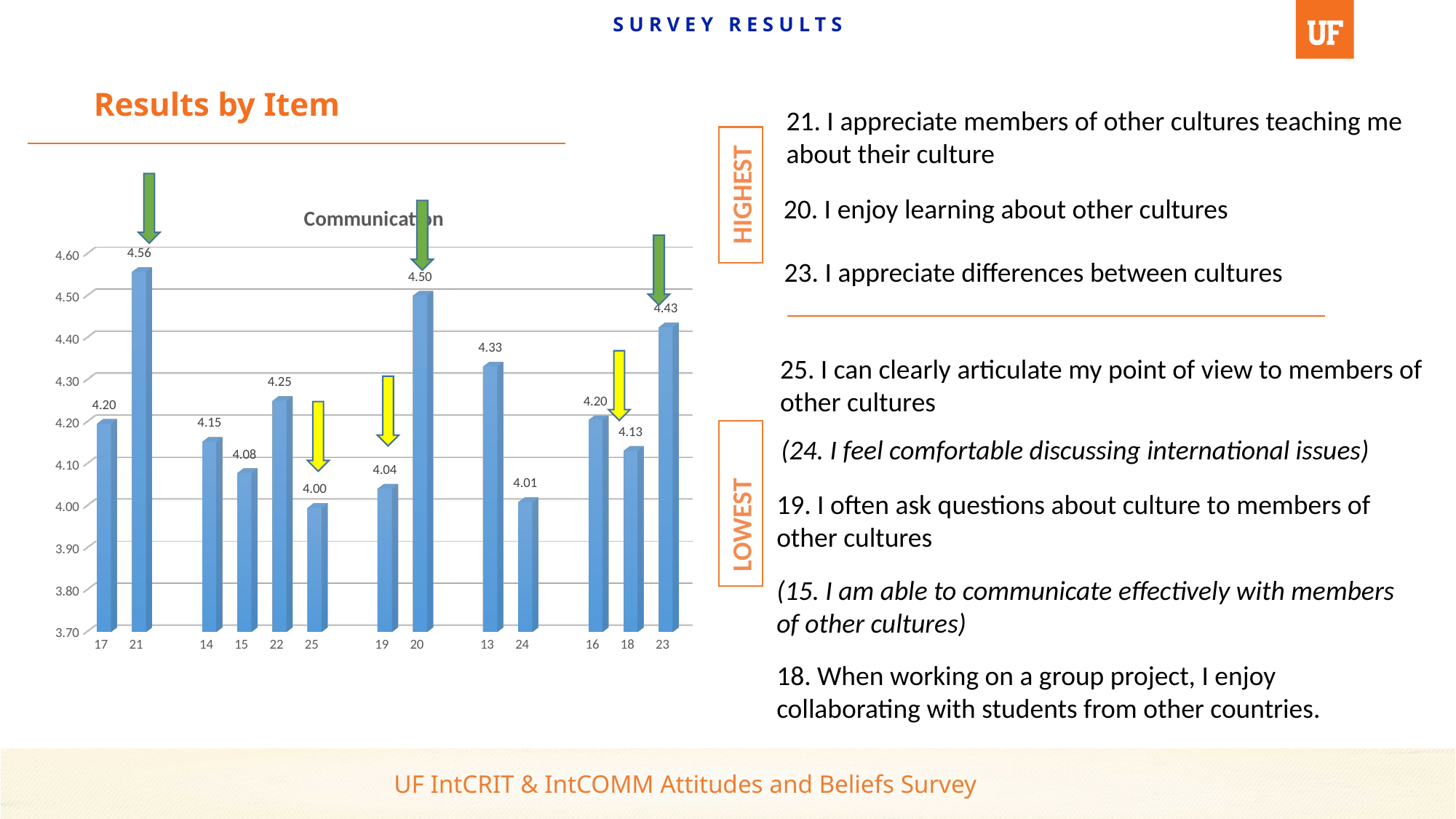
What is the difference between the values for item 21 and item 25? 0.56 Is the value for item 22 greater or less than 4.20? greater What is the title of the chart? Communication What is the value for item 21? 4.56 What is the value for item 13? 4.33 What is the value for item 25? 4.00 Which has a larger value, item 23 or item 13? 23 Which item has the lowest value? 25 What kind of chart is shown on the slide? bar chart How many items are plotted in the chart? 13 What is the difference between the values for item 20 and item 19? 0.46 Which item has the highest value? 21